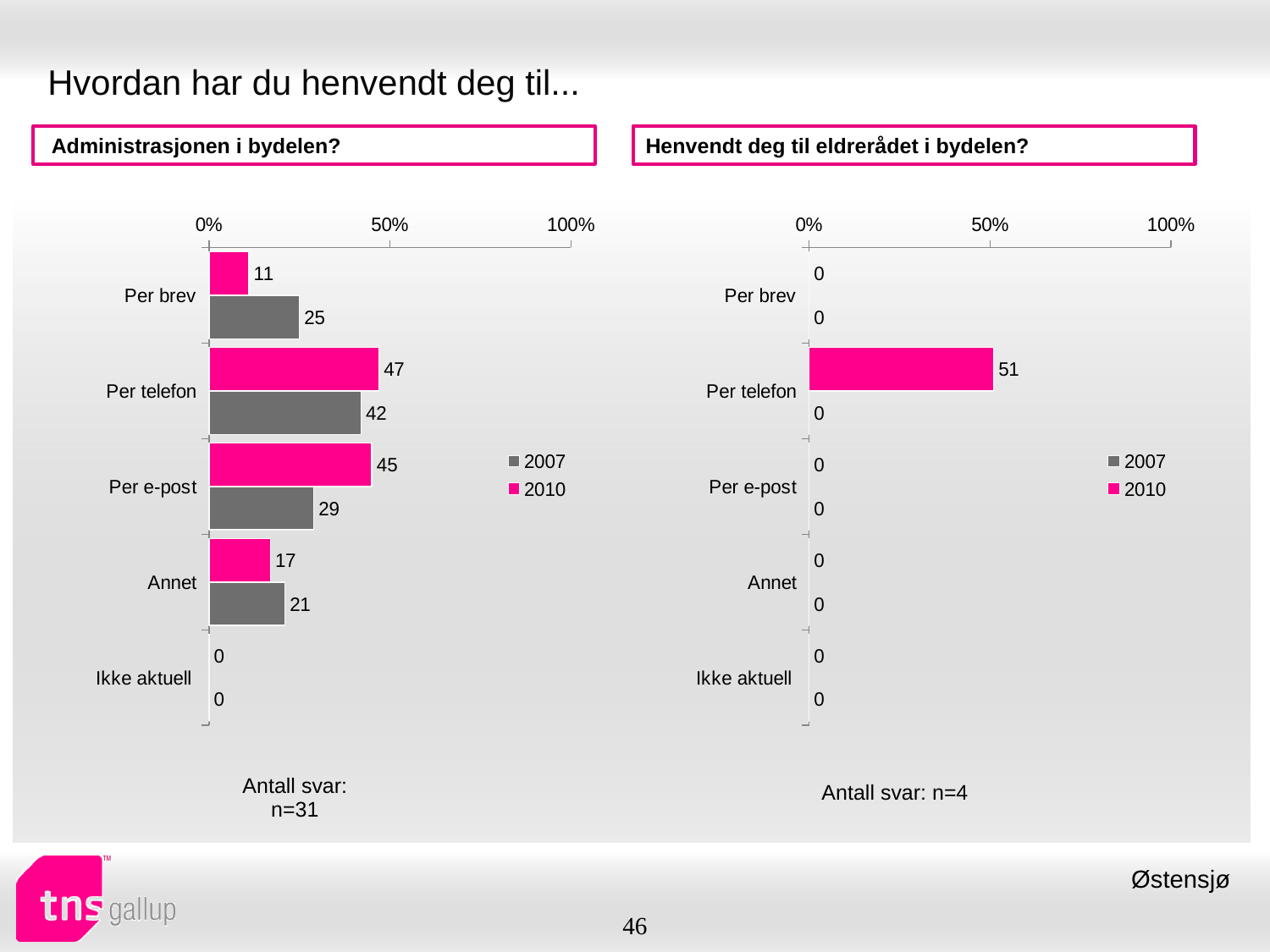
In the 'Administrasjonen i bydelen?' chart, what is the difference between the 2007 and 2010 values for Per brev? 14 In the 'Administrasjonen i bydelen?' chart, how many categories are shown on the vertical axis? 5 In the 'Administrasjonen i bydelen?' chart, which category has the lowest non-zero 2010 value? Per brev In the 'Administrasjonen i bydelen?' chart, what is the 2010 value for Per telefon? 47 In the 'Administrasjonen i bydelen?' chart, which category has the highest 2007 value? Per telefon How many series does the legend of the 'Henvendt deg til eldrerådet i bydelen?' chart list? 2 In the 'Henvendt deg til eldrerådet i bydelen?' chart, which category is the only one with a non-zero value? Per telefon In the 'Administrasjonen i bydelen?' chart, is the 2010 value for Per e-post larger or smaller than the 2007 value? larger In the 'Henvendt deg til eldrerådet i bydelen?' chart, what is the 2010 value for Per telefon? 51 In the 'Administrasjonen i bydelen?' chart, what is the 2007 value for Per e-post? 29 In the 'Henvendt deg til eldrerådet i bydelen?' chart, is the 2010 value for Per telefon greater or less than 50%? greater What type of chart is the 'Administrasjonen i bydelen?' chart? Bar chart